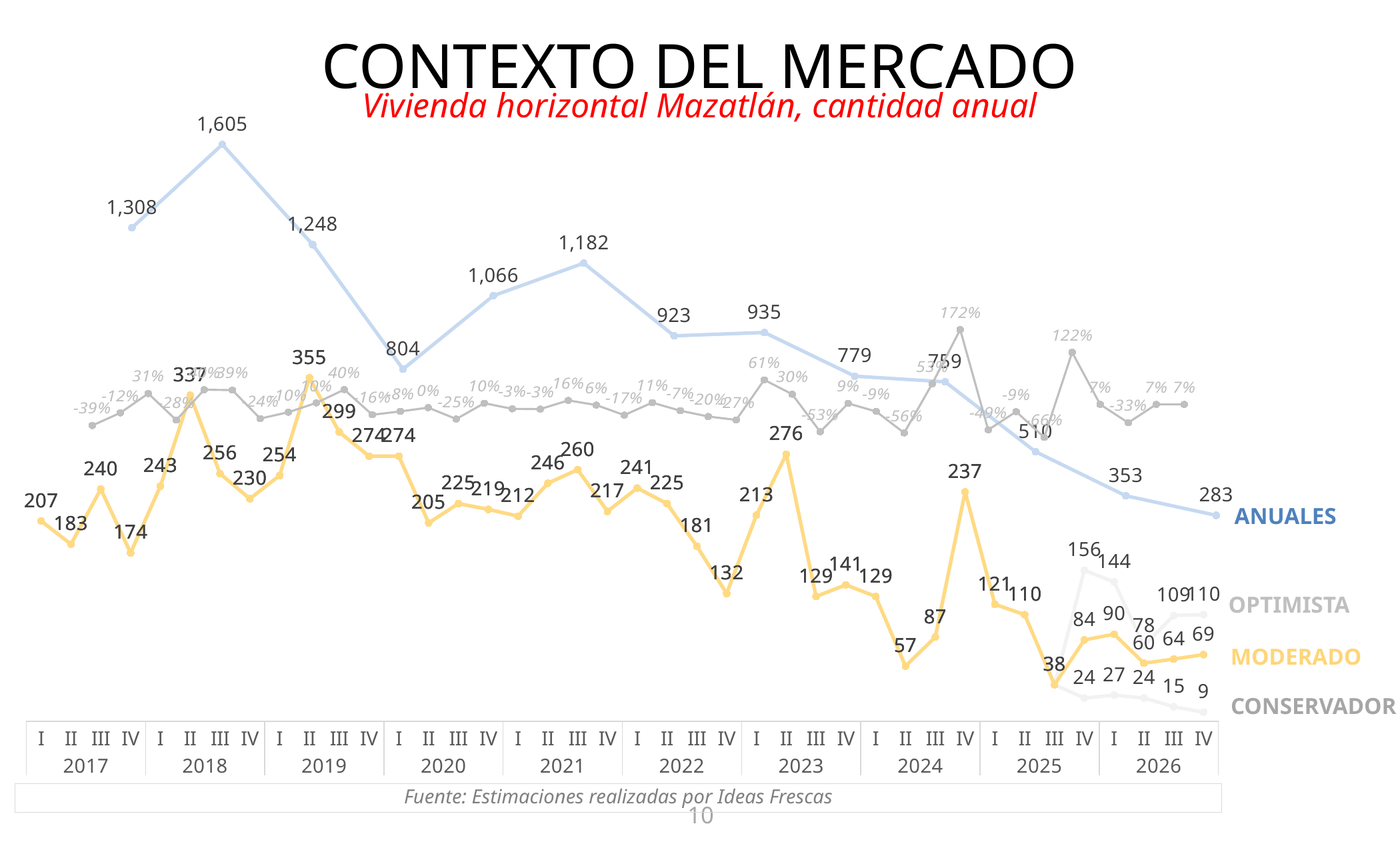
How many years are shown on the x axis? 10 Which is larger on the MODERADO line: quarter II of 2023 or quarter III of 2023? quarter II of 2023 What is the highest value labeled on the ANUALES line? 1,605 What is the difference between the two highest ANUALES values, 1,605 and 1,308? 297 What is the lowest value labeled on the ANUALES line? 283 What is the CONSERVADOR value for quarter IV of 2026? 9 What is the OPTIMISTA value for quarter IV of 2026? 110 What kind of chart is shown on the slide? line chart What is the highest value on the MODERADO line? 355 What source is cited below the chart? Estimaciones realizadas por Ideas Frescas What is the MODERADO value for quarter IV of 2024? 237 What is the lowest value on the MODERADO line? 38